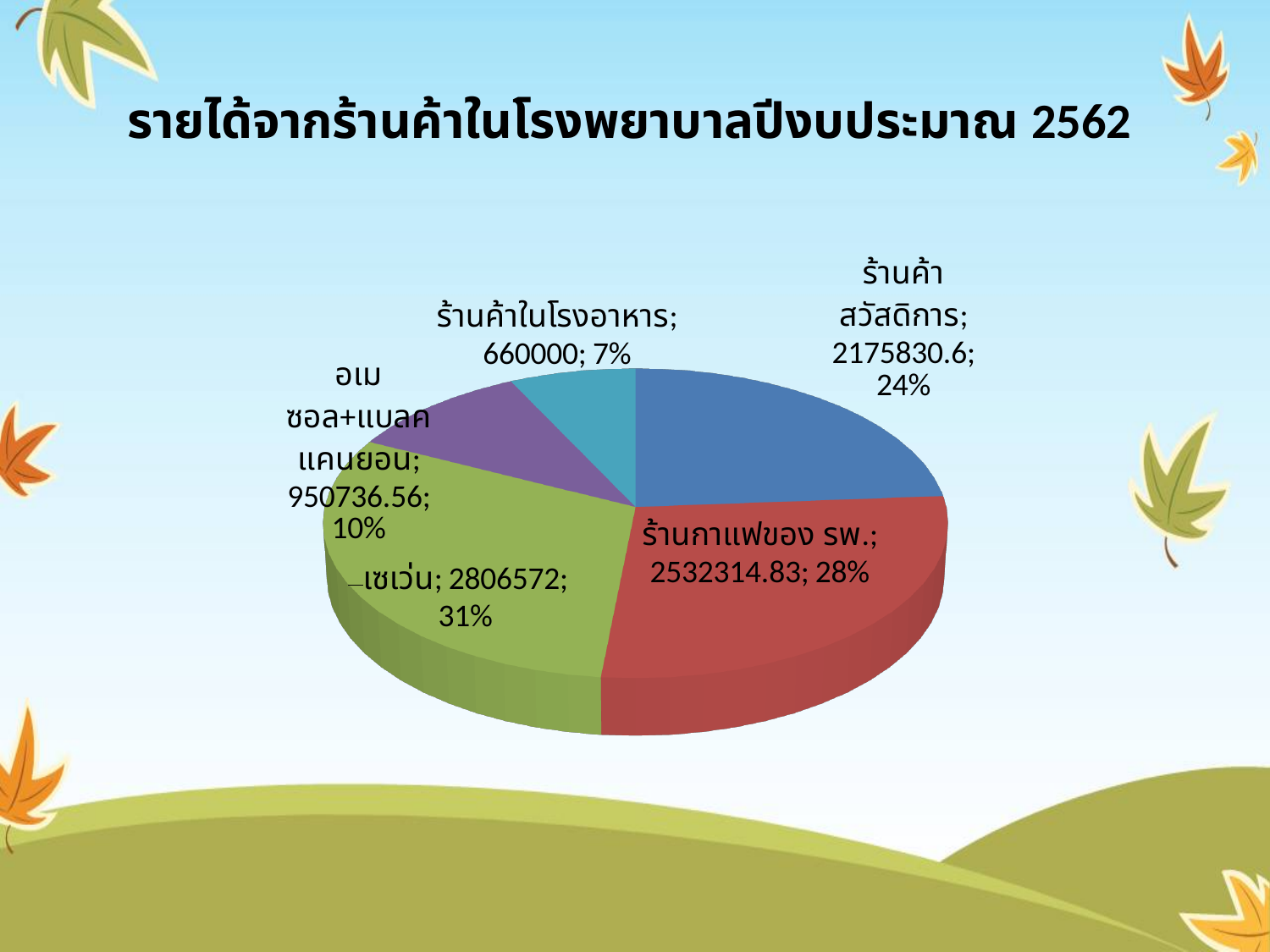
Which category has the largest slice of the pie? เซเว่น What is the value for เซเว่น? 2806572 What is the value for ร้านกาแฟของ รพ.? 2532314.83 Which is larger, the value for ร้านค้าสวัสดิการ or the value for อเมซอล+แบลคแคนยอน? ร้านค้าสวัสดิการ Which category has the smallest slice of the pie? ร้านค้าในโรงอาหาร What share of the pie does เซเว่น represent? 31% What is the value for ร้านค้าในโรงอาหาร? 660000 What is the difference between the values for เซเว่น and ร้านกาแฟของ รพ.? 274257.17 How many slices does the pie chart have? 5 What is the value for ร้านค้าสวัสดิการ? 2175830.6 What kind of chart is shown on the slide? Pie chart What share of the pie does อเมซอล+แบลคแคนยอน represent? 10%